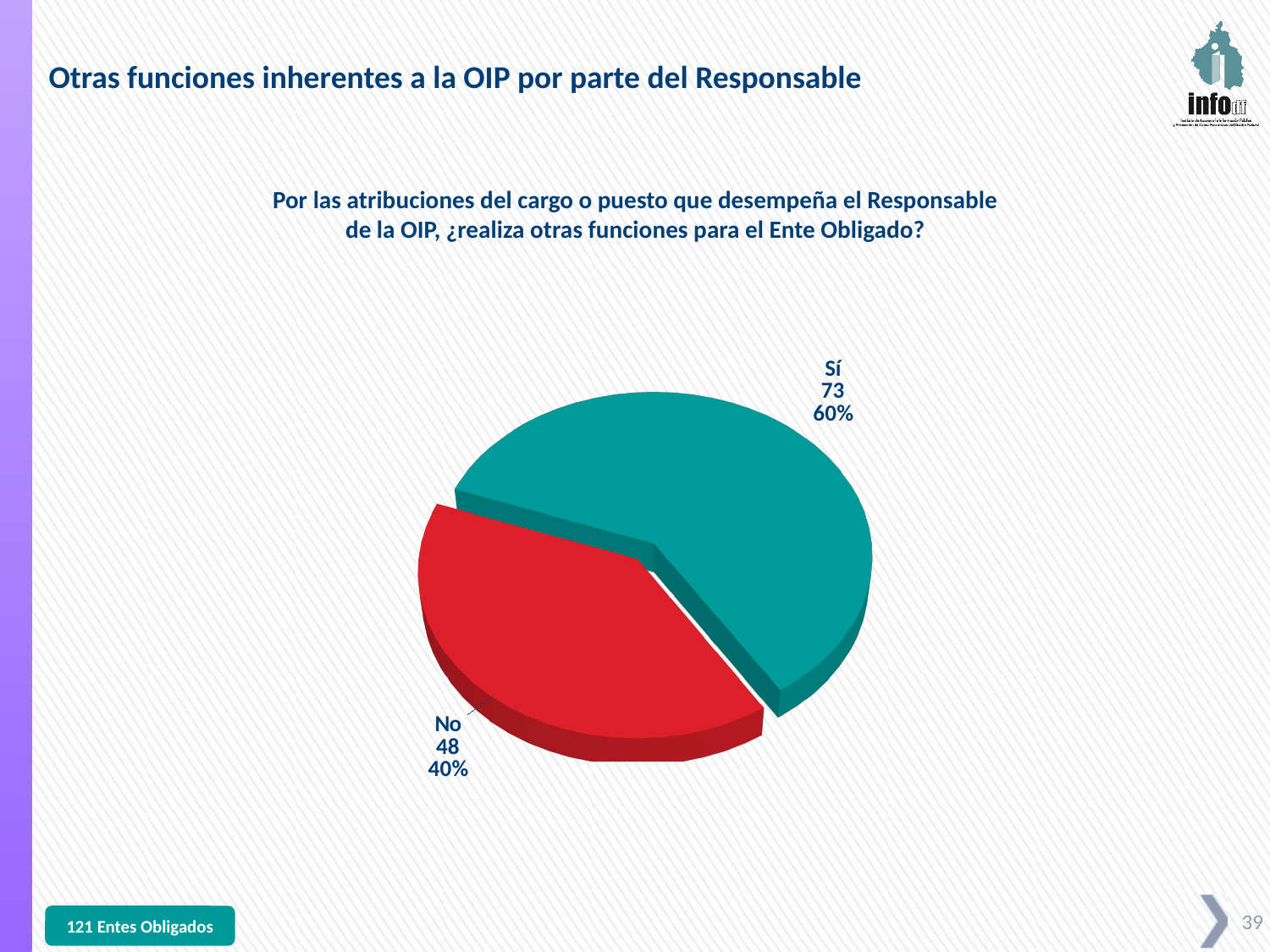
What is the difference between the number of "Sí" and "No" responses? 25 How many entities answered "Sí"? 73 Which category has the smallest slice? No Which is larger, the "Sí" slice or the "No" slice? Sí How many entities answered "No"? 48 What percentage of the pie does the "Sí" slice represent? 60% What colour is the "No" slice? red What kind of chart is shown on the slide? pie chart What percentage of the pie does the "No" slice represent? 40% Which category has the largest slice? Sí How many slices does the pie chart have? 2 What is the total of the two slices? 121